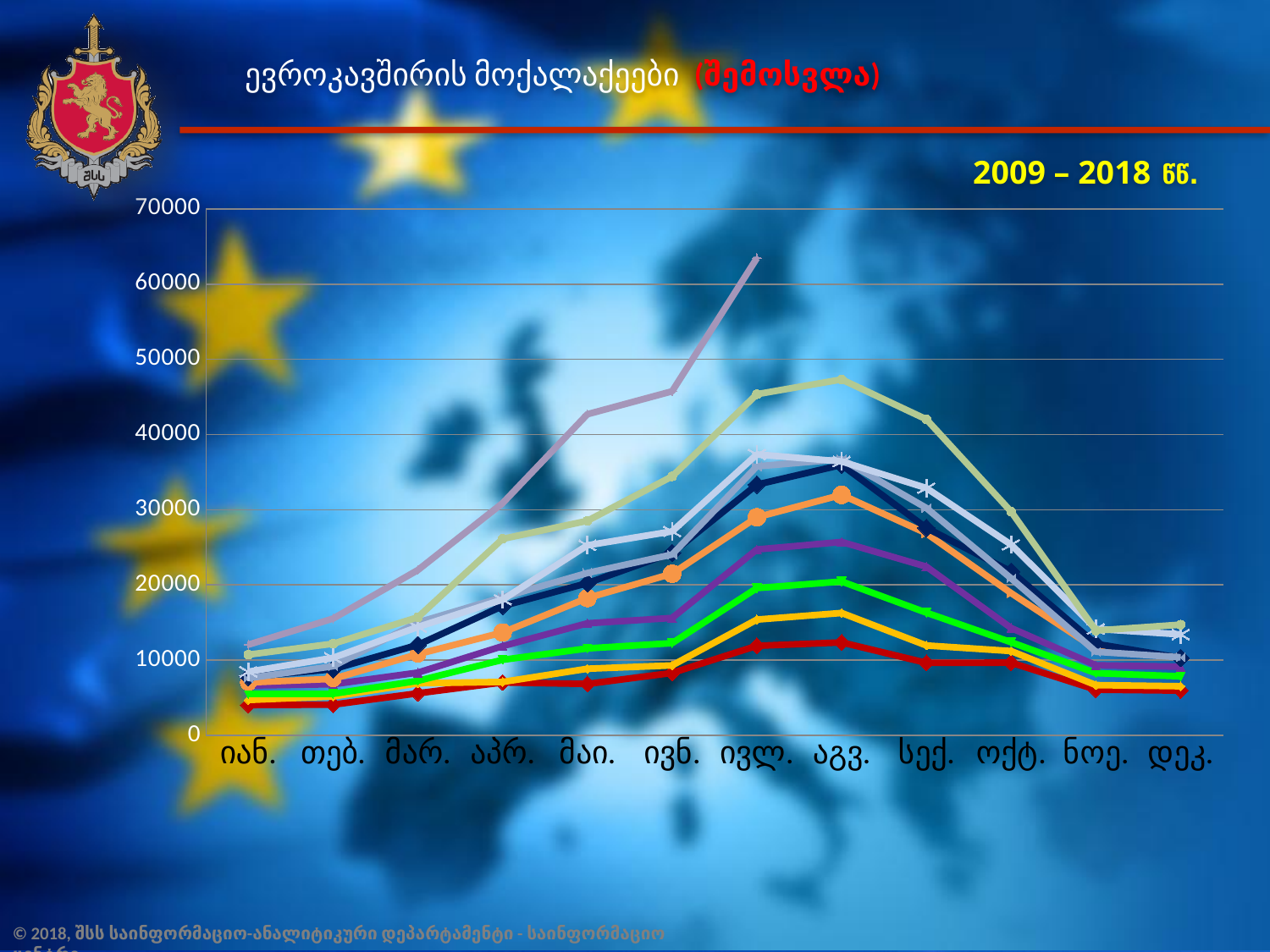
What year range is shown above the chart? 2009 – 2018 From იან. to ივლ., do the lines generally rise or fall? rise In which month does the line that stops early (the light purple line) end? ივლ. Is the peak of the lowest (red) line greater or less than 20000? less Is the value of the pale yellow line in აგვ. greater or less than 40000? greater From აგვ. to დეკ., do the lines generally rise or fall? fall Is the lowest value plotted for იან. greater or less than 10000? less How many categories (months) are shown along the x axis? 12 What kind of chart is shown on the slide? line chart